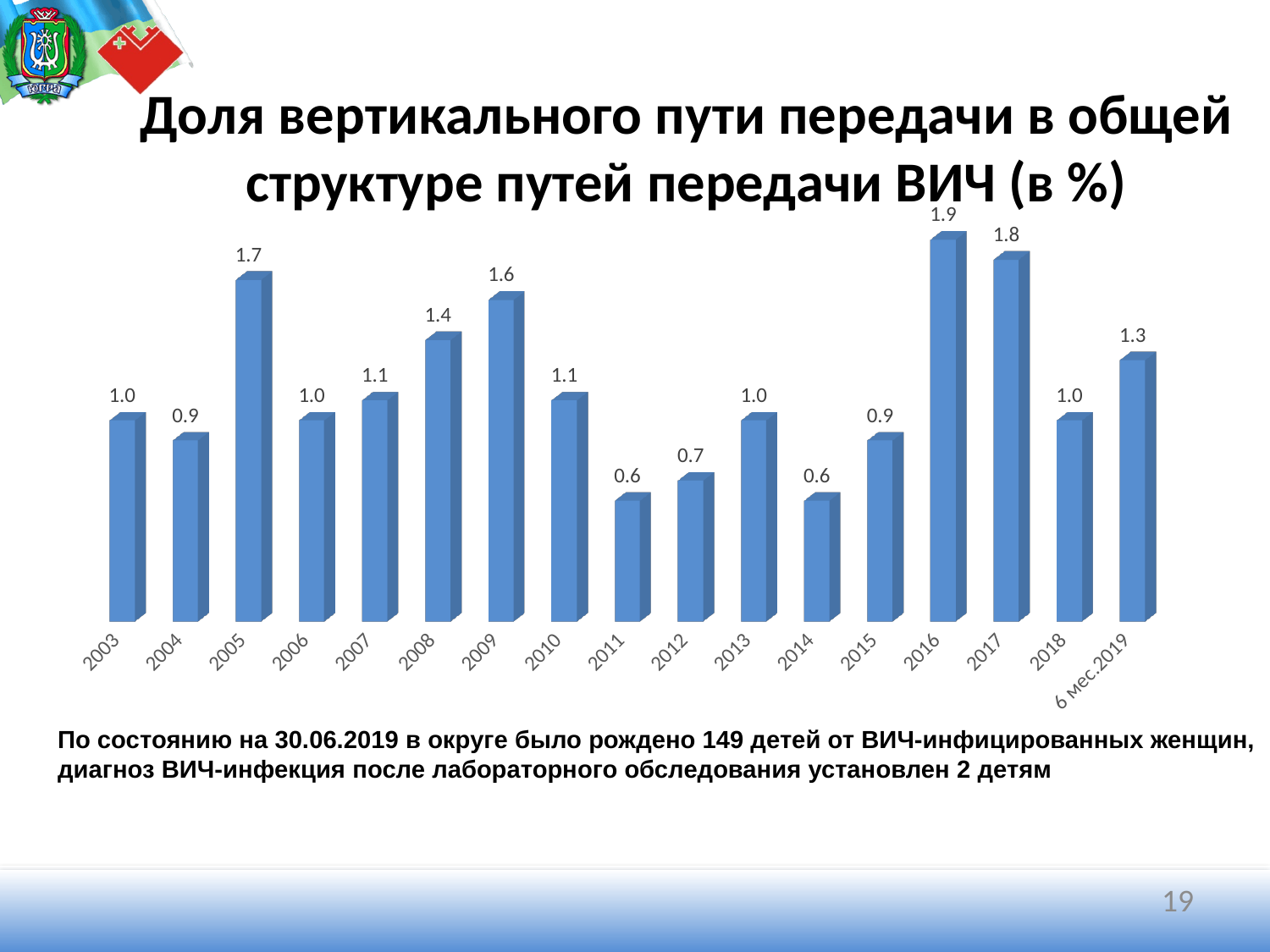
Which is larger, the value for 2009 or the value for 2008? 2009 What kind of chart is shown on the slide? Bar chart What is the value for 2016? 1.9 What is the difference between the values for 2016 and 2011? 1.3 Which year has the highest value? 2016 Do the values rise or fall from 2009 to 2011? Fall What is the value for 6 мес.2019? 1.3 What is the value for 2012? 0.7 What is the value for 2005? 1.7 What colour are the bars in the chart? Blue What is the difference between the values for 2017 and 2018? 0.8 How many bars are shown in the chart? 17